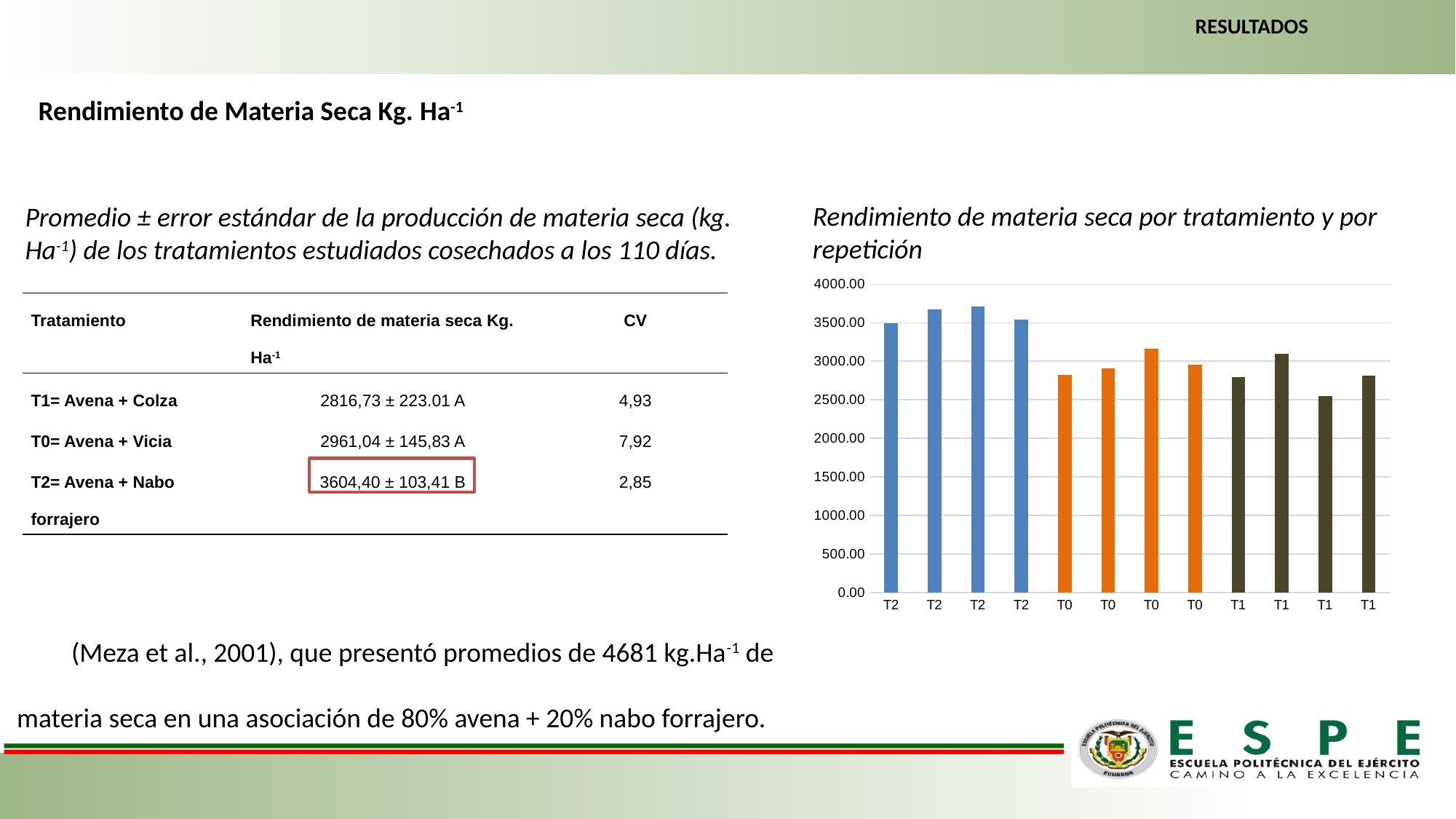
Is the value of the third T1 bar (eleventh bar from the left) greater or less than 3000? less How many bars are plotted in the chart 'Rendimiento de materia seca por tratamiento y por repetición'? 12 Which treatment label does the shortest bar in the chart belong to? T1 Is the value of the first T0 bar (fifth bar from the left) greater or less than 3000? less What is the highest tick value shown on the y axis of the chart? 4000.00 Is the value of the third bar from the left (T2) greater or less than 3500? greater How many different treatment labels (T0, T1, T2) appear on the x axis of the chart? 3 Which is larger: the third bar from the left (T2) or the eleventh bar from the left (T1)? the third bar (T2) Which treatment label does the tallest bar in the chart belong to? T2 What colour are the T0 bars in the chart? orange What kind of chart is shown on the right side of the slide? bar chart